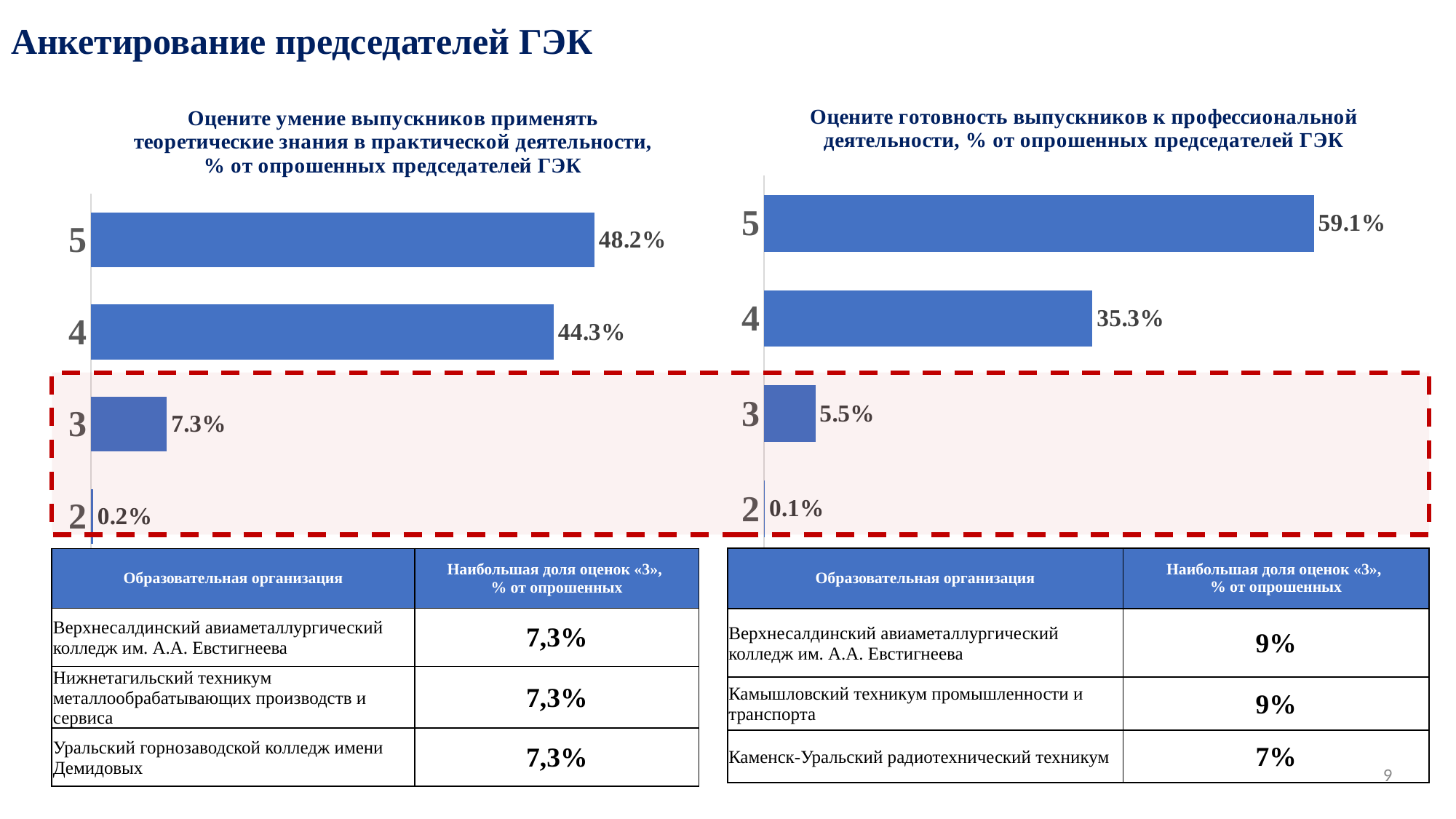
Which is larger: the value for rating 3 in the left chart or the value for rating 3 in the right chart? Left chart (7.3%) In the right chart, what is the difference between the values for rating 5 and rating 4? 23.8% In the right chart, what is the value for rating 2? 0.1% In the left chart, what percentage of respondents gave a rating of 5? 48.2% What type of chart is the right chart? Bar chart In the left chart, which rating has the lowest share of respondents? 2 In the left chart, what is the difference between the values for rating 5 and rating 4? 3.9% How many rating categories are shown in the left chart? 4 In the left chart, what is the value for rating 3? 7.3% In the right chart, do the values rise or fall as the rating goes from 5 down to 2? Fall In the right chart, what percentage of respondents gave a rating of 4? 35.3% In the right chart, which rating has the highest share of respondents? 5